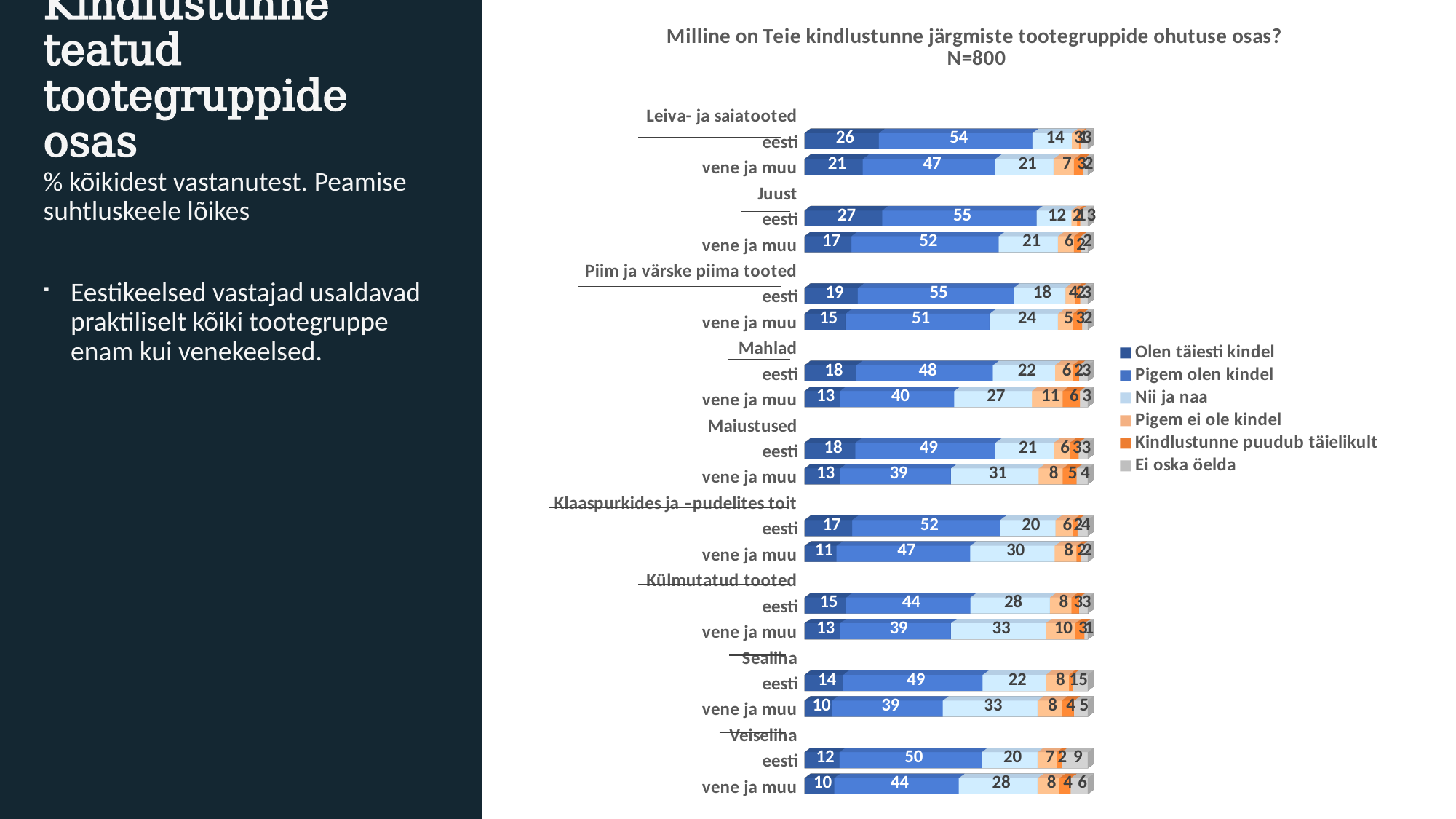
Which row has the highest 'Olen täiesti kindel' value? Juust, eesti What kind of chart is shown on the slide? bar chart Which row has the highest 'Pigem ei ole kindel' value? Mahlad, vene ja muu What is the sample size (N) stated in the chart title? N=800 How many product groups are shown on the chart? 9 What is the difference between the 'Pigem olen kindel' values for Leiva- ja saiatooted eesti and vene ja muu? 7 What is the 'Pigem olen kindel' value for Veiseliha, eesti? 50 What is the 'Nii ja naa' value for Külmutatud tooted, vene ja muu? 33 How many series does the legend list? 6 For Mahlad, which has the larger 'Nii ja naa' value: eesti or vene ja muu? vene ja muu What is the 'Pigem olen kindel' value for Leiva- ja saiatooted, vene ja muu? 47 What is the 'Olen täiesti kindel' value for Juust, eesti? 27